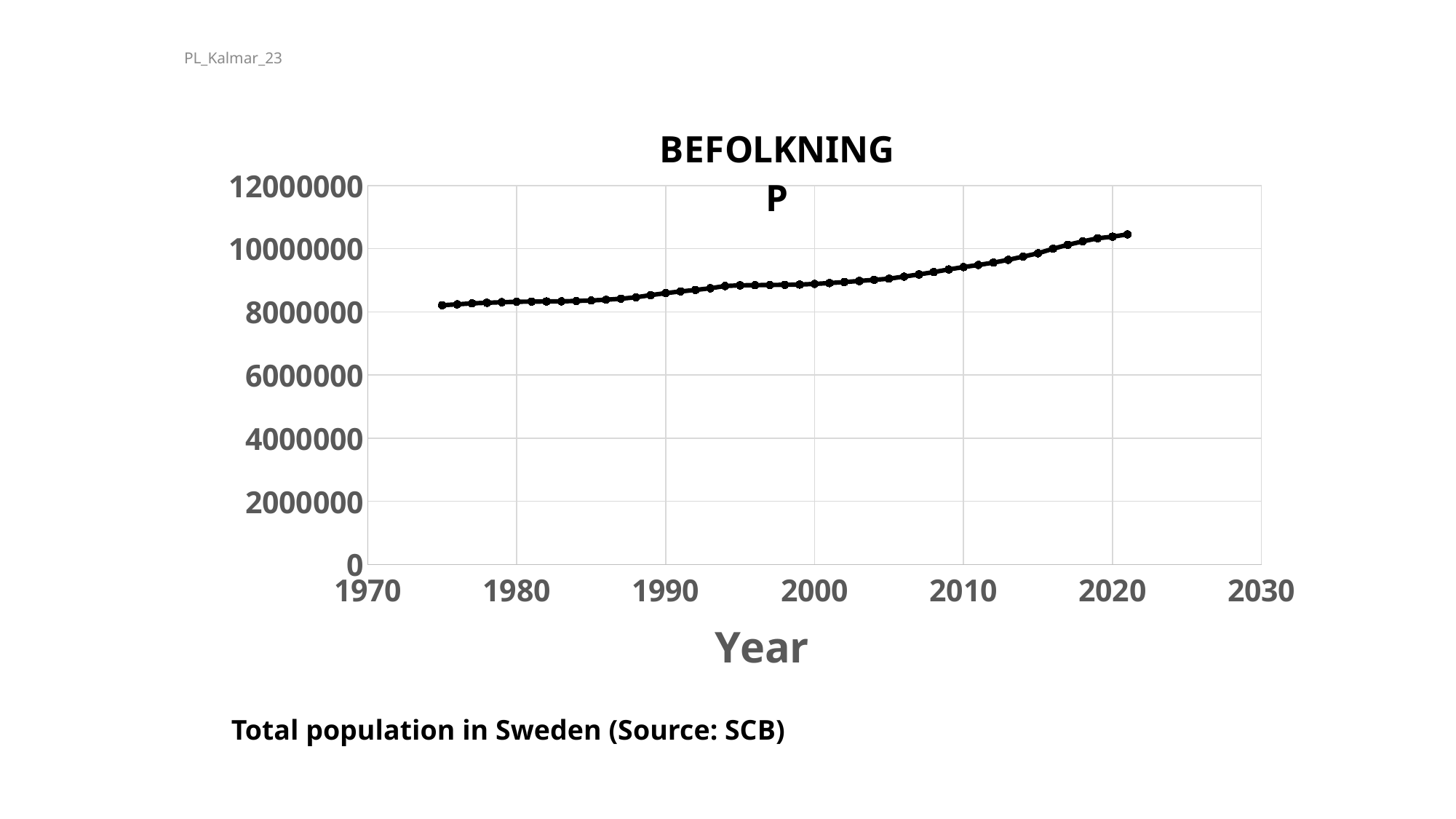
Do the values rise or fall along the x axis from 1975 to 2021? rise Is the value for 2020 greater or less than 10000000? greater Is the value for 1975 greater or less than 6000000? greater What kind of chart is shown on the slide? line chart Is the value for 1980 greater or less than 10000000? less Which is larger, the value for 1980 or the value for 2020? 2020 Which is larger, the value for 2010 or the value for 1990? 2010 What is the title of the chart? BEFOLKNING P What is the label of the x axis? Year